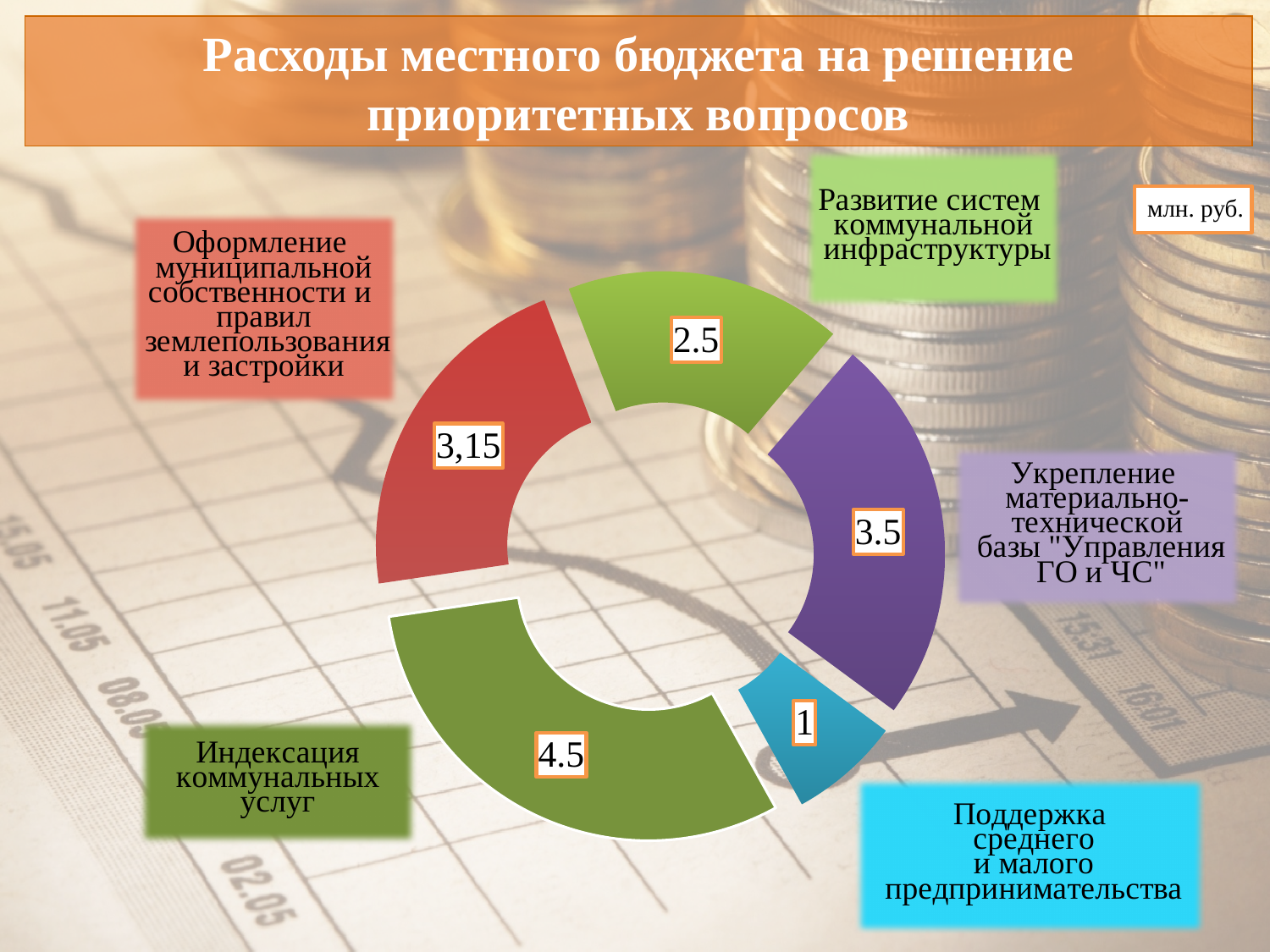
What is the difference between the values for Индексация коммунальных услуг and Развитие систем коммунальной инфраструктуры? 2 Which category has the highest value? Индексация коммунальных услуг What is the value for Развитие систем коммунальной инфраструктуры? 2.5 How many segments does the chart have? 5 Which is larger: the value for Укрепление материально-технической базы "Управления ГО и ЧС" or the value for Развитие систем коммунальной инфраструктуры? Укрепление материально-технической базы "Управления ГО и ЧС" What kind of chart is shown on the slide? doughnut chart What is the value for Поддержка среднего и малого предпринимательства? 1 In what units are the chart values given? млн. руб. What is the value for Индексация коммунальных услуг? 4.5 What is the value for Укрепление материально-технической базы "Управления ГО и ЧС"? 3.5 What is the value for Оформление муниципальной собственности и правил землепользования и застройки? 3,15 Which category has the lowest value? Поддержка среднего и малого предпринимательства